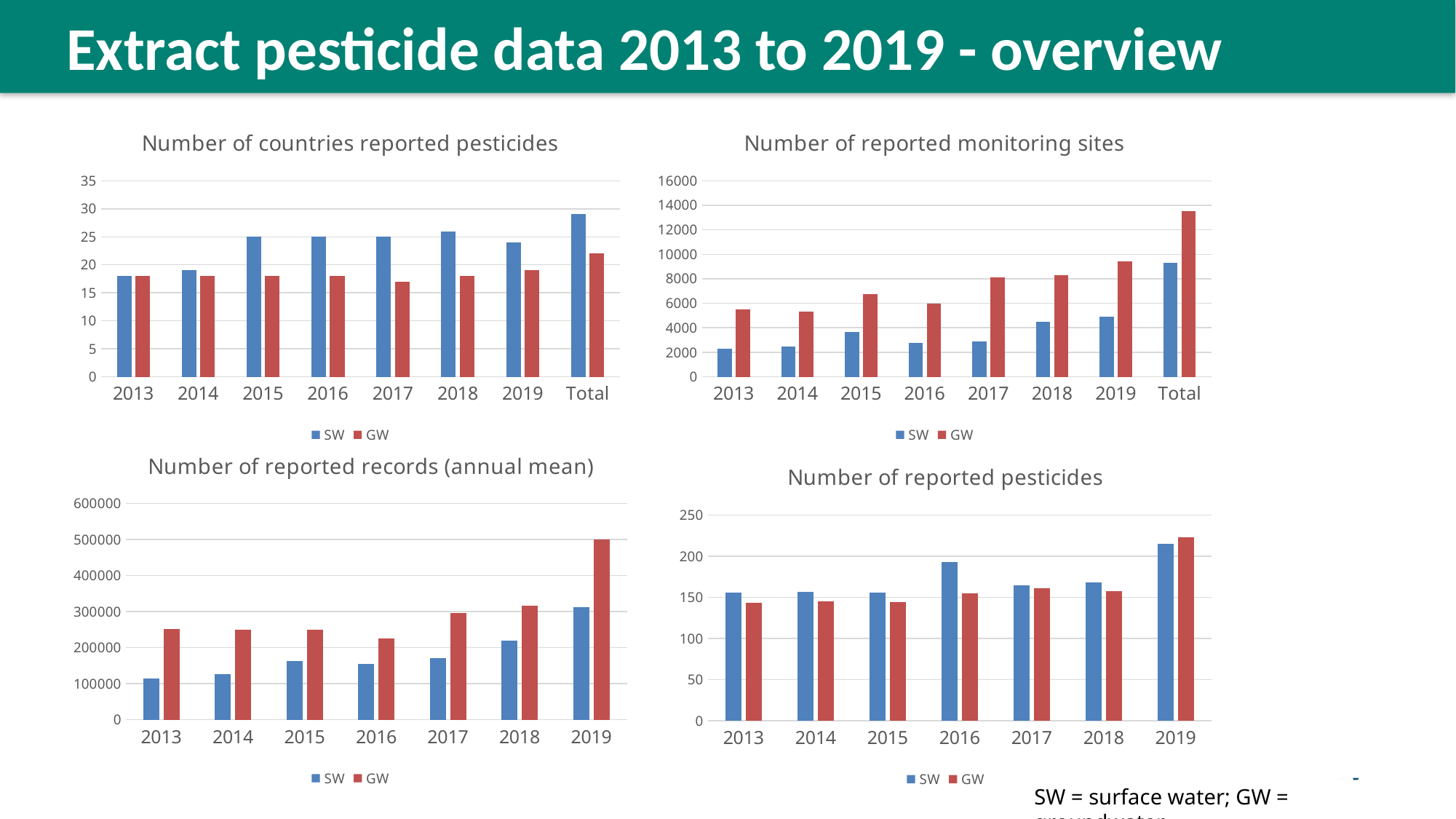
What kind of chart is 'Number of reported monitoring sites'? Bar chart In the 'Number of reported records (annual mean)' chart, is the GW value for 2019 greater or less than 400000? greater In the 'Number of countries reported pesticides' chart, is the GW value for 2017 greater or less than 20? less In the 'Number of reported monitoring sites' chart, which is larger for 2013, SW or GW? GW In the 'Number of reported pesticides' chart, which is larger for 2016, SW or GW? SW How many categories are shown on the x axis of the 'Number of reported records (annual mean)' chart? 7 How many series does the legend list in the 'Number of reported pesticides' chart? 2 In the 'Number of countries reported pesticides' chart, is the SW value for Total greater or less than 25? greater In the 'Number of reported records (annual mean)' chart, do the GW values rise or fall from 2017 to 2019? rise How many categories are shown on the x axis of the 'Number of countries reported pesticides' chart? 8 In the 'Number of reported monitoring sites' chart, which category has the highest GW bar? Total In the 'Number of reported records (annual mean)' chart, which year has the lowest SW bar? 2013